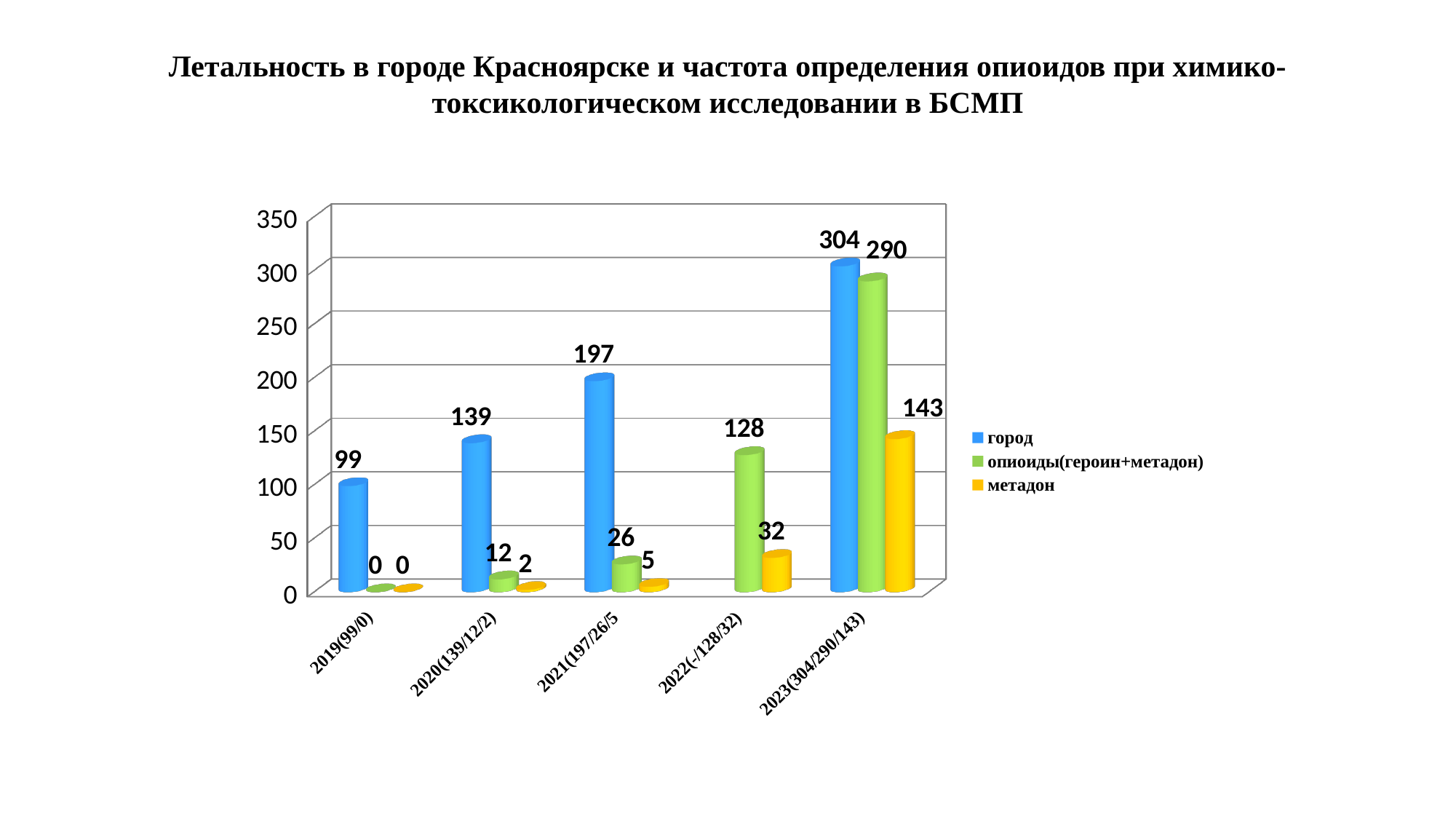
In which category is the город series highest? 2023(304/290/143) Which is larger in 2021(197/26/5: опиоиды(героин+метадон) or метадон? опиоиды(героин+метадон) What is the difference between город and опиоиды(героин+метадон) in 2023(304/290/143)? 14 What is the value for метадон in 2023(304/290/143)? 143 What is the value for опиоиды(героин+метадон) in 2022(-/128/32)? 128 What is the value for город in 2021(197/26/5? 197 How many series does the legend list? 3 What kind of chart is shown on the slide? bar chart What is the value for метадон in 2020(139/12/2)? 2 How many categories are shown on the x axis? 5 Does the метадон series rise or fall from 2019 to 2023? rise In which category is the опиоиды(героин+метадон) series lowest? 2019(99/0)